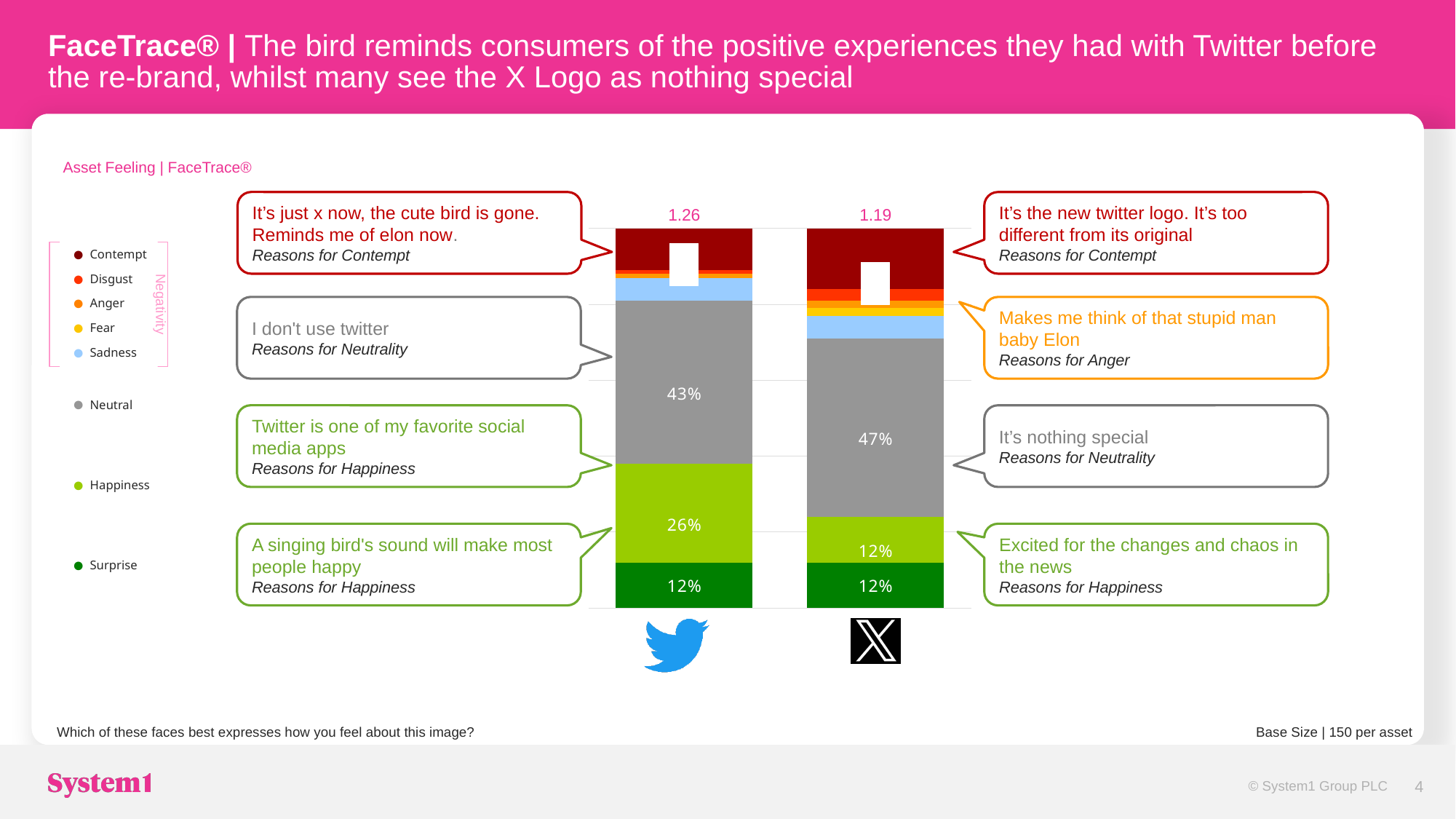
What is the Happiness percentage for the Twitter bird logo? 26% What percentage of respondents felt Neutral about the X logo? 47% Which logo has the higher Happiness percentage, the Twitter bird or the X logo? Twitter bird logo What percentage of respondents felt Neutral about the Twitter bird logo? 43% What is the Surprise percentage for the X logo? 12% How many percentage points higher is the Happiness share for the Twitter bird logo than for the X logo? 14 percentage points What is the Happiness percentage for the X logo? 12% What score is printed above the Twitter bird logo bar? 1.26 How many percentage points higher is the Neutral share for the X logo than for the Twitter bird logo? 4 percentage points How many emotions does the legend list? 8 What kind of chart is shown on the slide? Stacked bar chart What score is printed above the X logo bar? 1.19